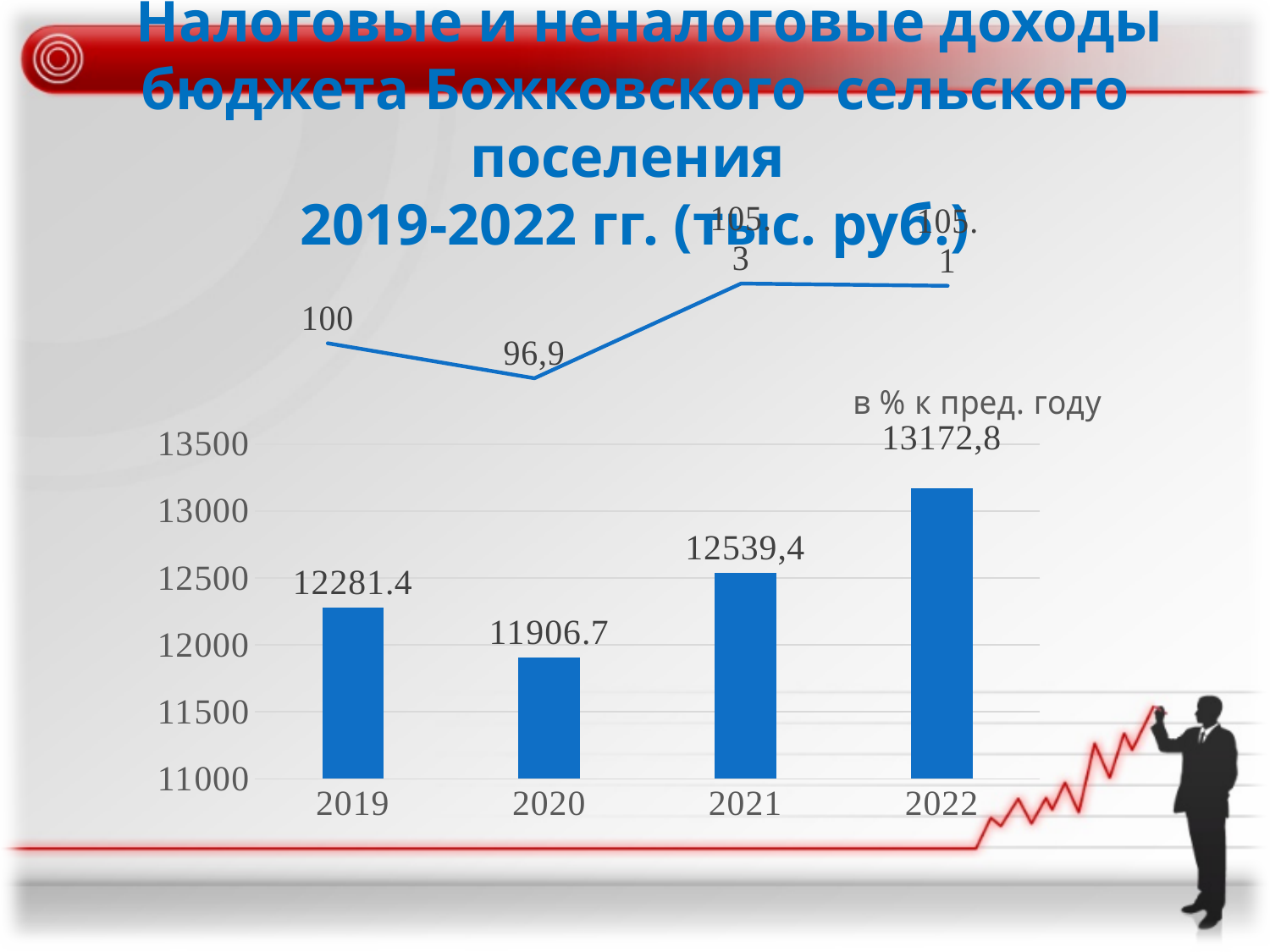
In the bar chart, do the values rise or fall from 2020 to 2022? rise In the bar chart, what is the difference between the values for 2022 and 2021? 633,4 In the bar chart, which year has the highest value? 2022 In the bar chart, which year has the lowest value? 2020 In the bar chart, what is the value for 2019? 12281.4 How many years are shown on the x axis of the bar chart? 4 In the bar chart, what is the value for 2021? 12539,4 In the line chart above the bars, what is the value for 2020? 96,9 What kind of chart shows the budget revenue values by year? bar chart In the bar chart, which is larger, the value for 2019 or the value for 2021? 2021 In the bar chart, what is the value for 2020? 11906.7 In the bar chart, what is the value for 2022? 13172,8